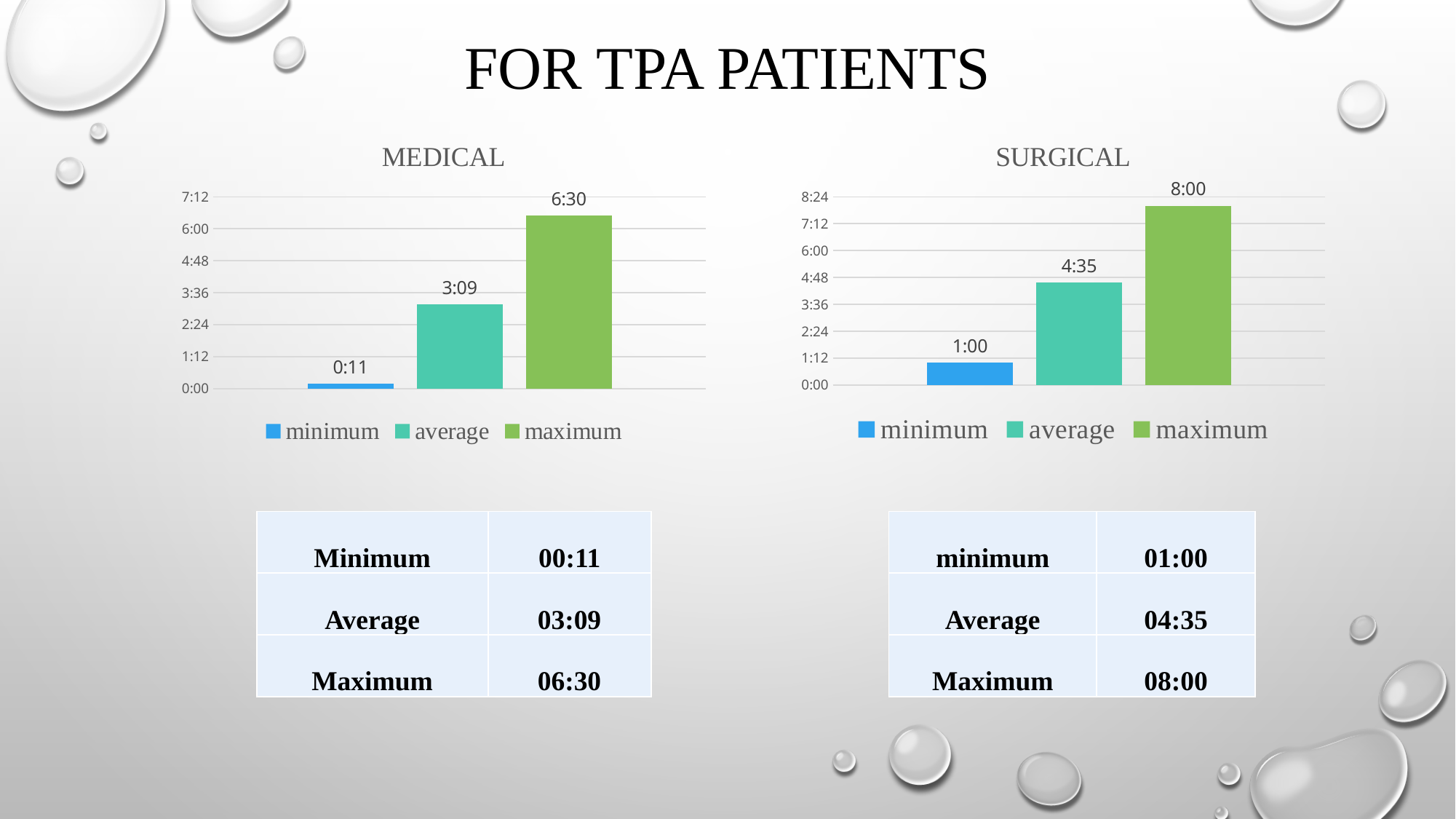
In the MEDICAL chart, what is the value for average? 3:09 In the SURGICAL chart, which series has the highest value? maximum What kind of chart is the MEDICAL chart? bar chart In the MEDICAL chart, what is the value for maximum? 6:30 In the SURGICAL chart, what is the value for minimum? 1:00 In the MEDICAL chart, is the value for average greater or less than 2:24? greater How many series does the legend of the SURGICAL chart list? 3 In the MEDICAL chart, which series has the lowest value? minimum In the SURGICAL chart, what is the value for average? 4:35 What is the title of the chart on the right side of the slide? SURGICAL Which is larger: the average in the MEDICAL chart or the average in the SURGICAL chart? SURGICAL average In the SURGICAL chart, what is the difference between the maximum and the minimum? 7:00